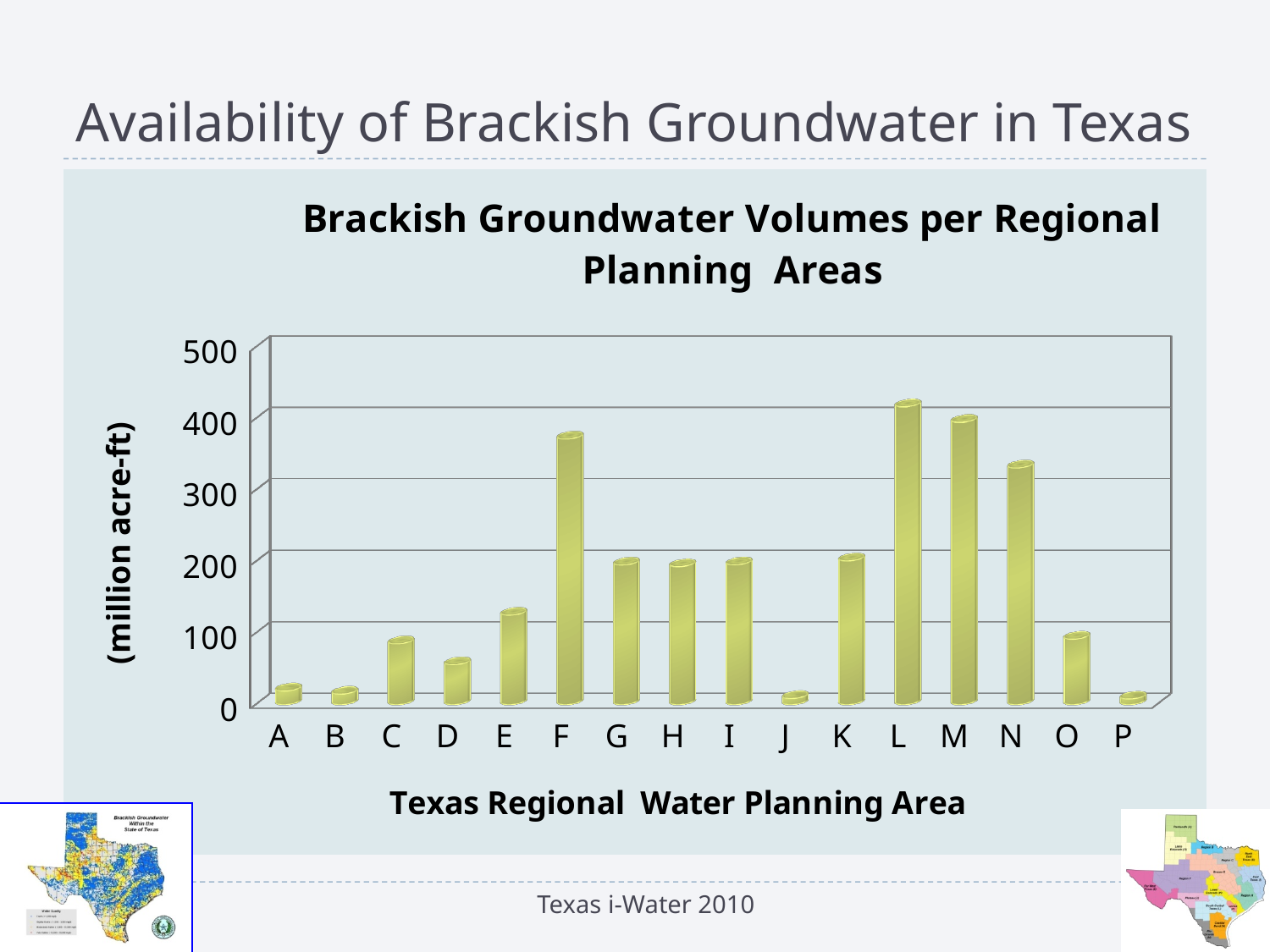
Is the value for area F greater or less than 300? greater Is the value for area L greater or less than 400? greater Which has the larger brackish groundwater volume, area C or area D? C How many regional water planning areas are plotted on the x axis? 16 What unit is shown on the y-axis label of the chart? million acre-ft Is the value for area D greater or less than 100? less What is the title of the chart? Brackish Groundwater Volumes per Regional Planning Areas Which has the larger brackish groundwater volume, area F or area N? F Which regional water planning area has the highest brackish groundwater volume? L What kind of chart is shown on the slide? bar chart